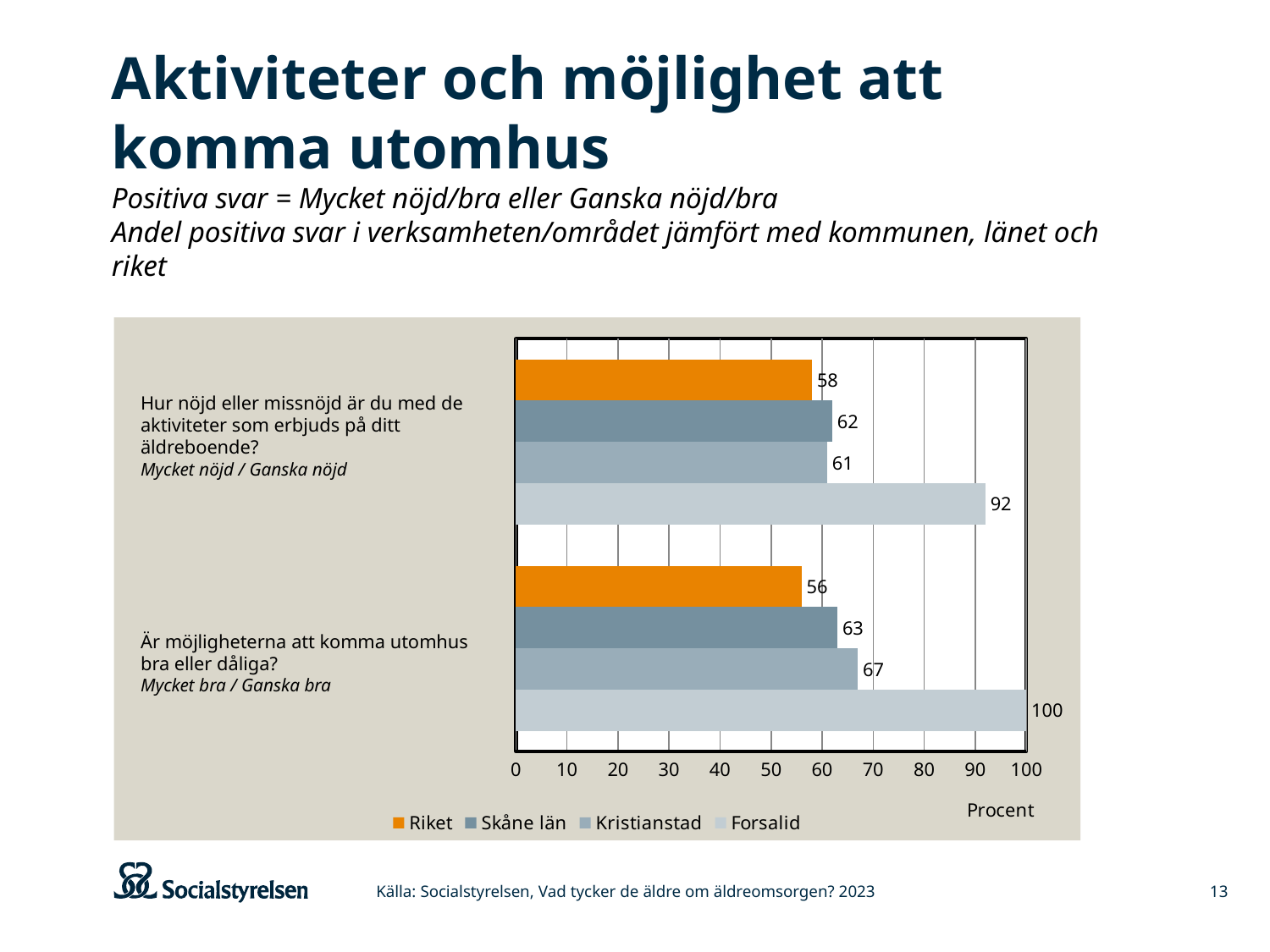
Which is larger on the question about opportunities to get outdoors: Skåne län or Kristianstad? Kristianstad What is the difference between Forsalid and Kristianstad on the question about activities offered at the care home? 31 What is the difference between Forsalid and Riket on the question about opportunities to get outdoors? 44 What is the value for Kristianstad on the question about opportunities to get outdoors? 67 Which series has the highest value on the question about opportunities to get outdoors? Forsalid What unit is shown on the x axis of the chart? Procent Which series has the lowest value on the question about activities offered at the care home? Riket What is the value for Riket on the question about opportunities to get outdoors ("Är möjligheterna att komma utomhus bra eller dåliga?")? 56 What kind of chart is shown on the slide? Bar chart How many series does the legend list? 4 What is the value for Forsalid on the question about activities offered at the care home ("Hur nöjd eller missnöjd är du med de aktiviteter som erbjuds på ditt äldreboende?")? 92 What is the value for Skåne län on the question about activities offered at the care home? 62